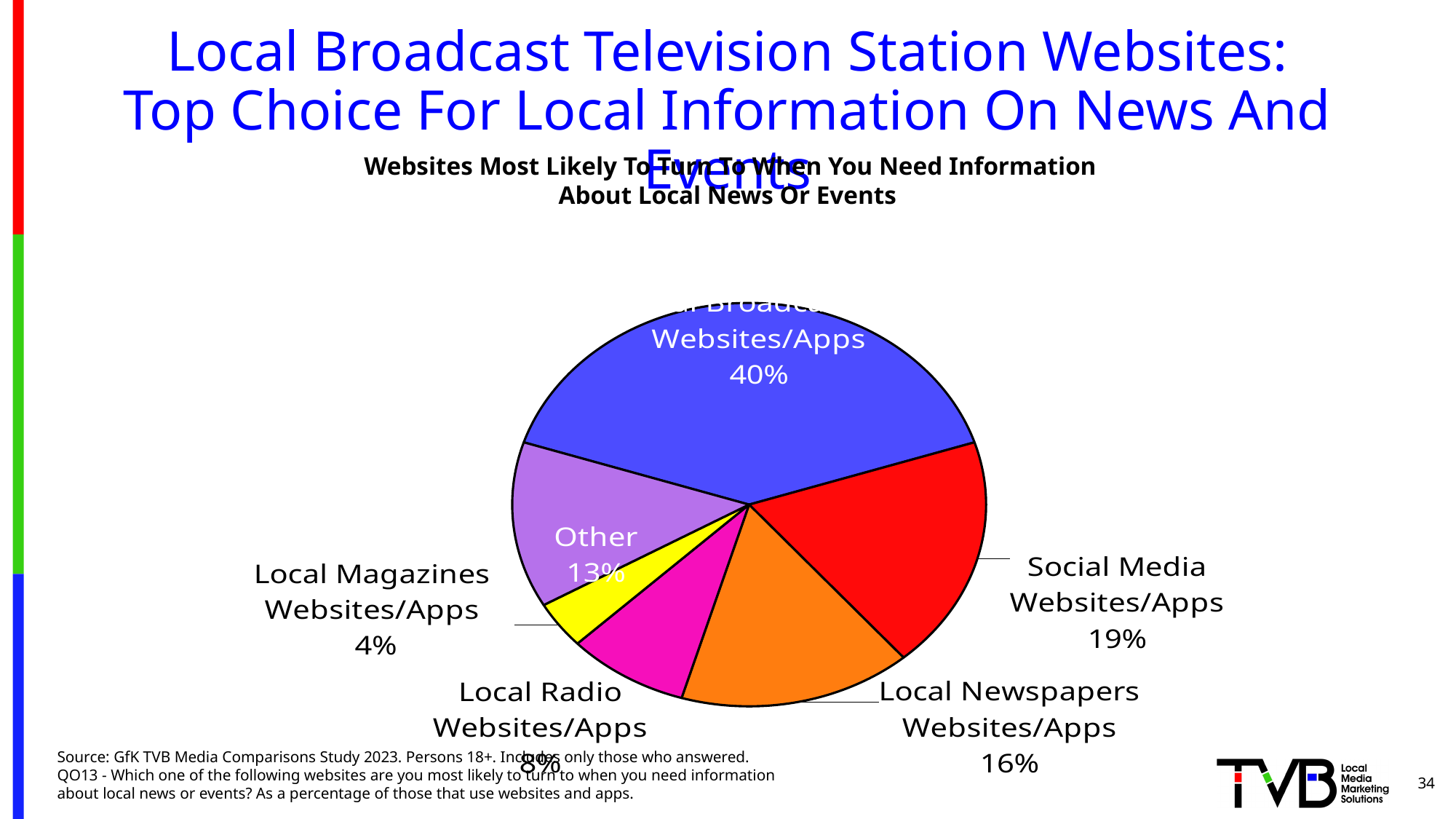
What share of the pie is Local Magazines Websites/Apps? 4% What kind of chart is shown on the slide? pie chart Which is larger, Local Radio Websites/Apps or Local Magazines Websites/Apps? Local Radio Websites/Apps How many slices does the pie chart have? 6 What percentage is shown on the largest slice of the pie? 40% What share of the pie is Social Media Websites/Apps? 19% What colour is the Social Media Websites/Apps slice? red What share of the pie is the Other slice? 13% What share of the pie is Local Radio Websites/Apps? 8% Which category has the smallest slice of the pie? Local Magazines Websites/Apps What share of the pie is Local Newspapers Websites/Apps? 16% What is the difference in percentage points between Social Media Websites/Apps and Local Newspapers Websites/Apps? 3